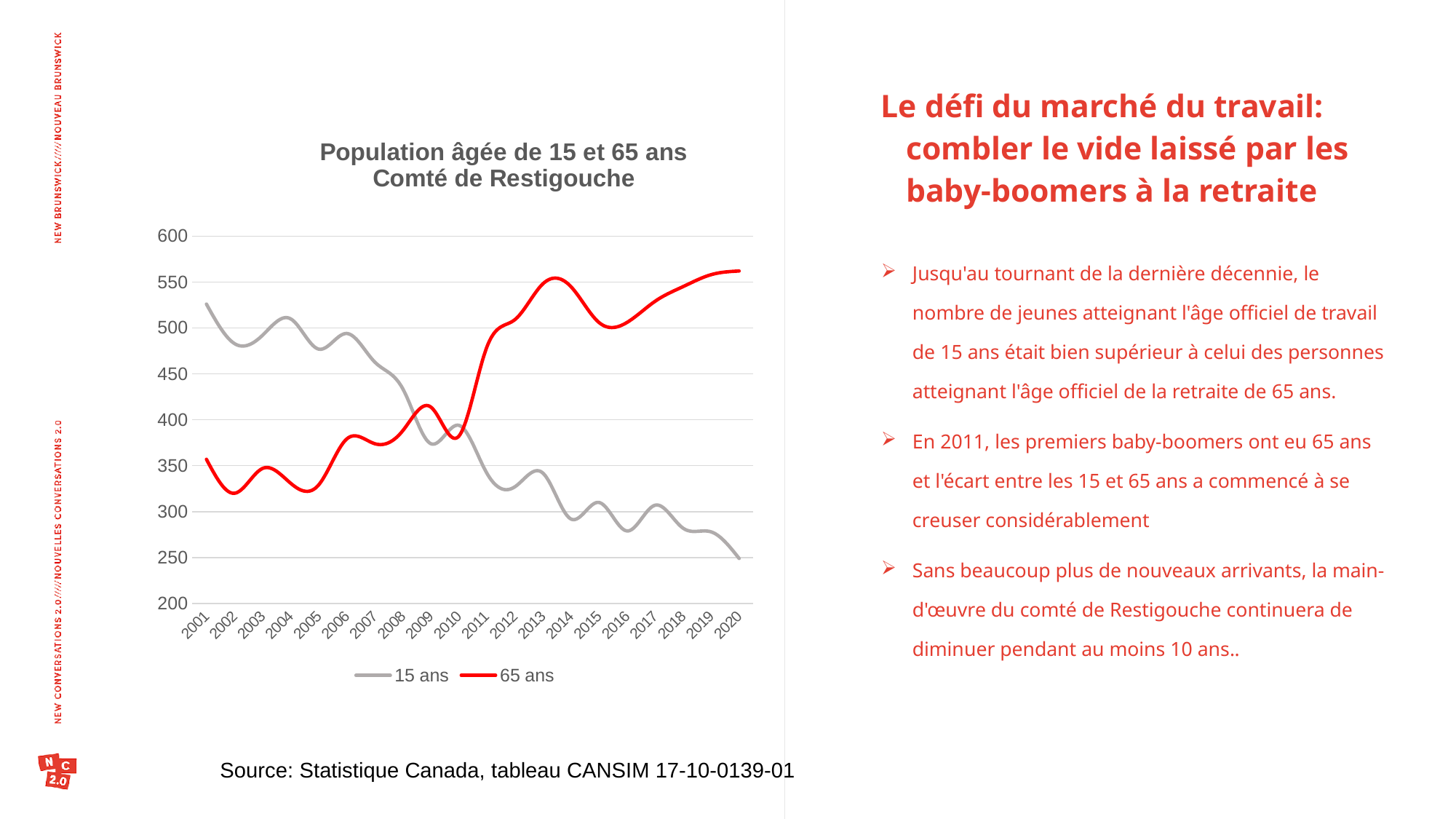
Does the 65 ans series rise or fall overall from 2001 to 2020? Rise How many years are plotted along the x axis? 20 Is the value for 15 ans in 2001 greater or less than 500? greater Is the value for 15 ans in 2020 greater or less than 300? less Which series is drawn in red? 65 ans In 2001, which series has the larger value, 15 ans or 65 ans? 15 ans Does the 15 ans series rise or fall overall from 2001 to 2020? Fall In 2020, which series has the larger value, 15 ans or 65 ans? 65 ans Is the value for 65 ans in 2020 greater or less than 550? greater How many series does the legend list? 2 What kind of chart is shown on the slide? Line chart